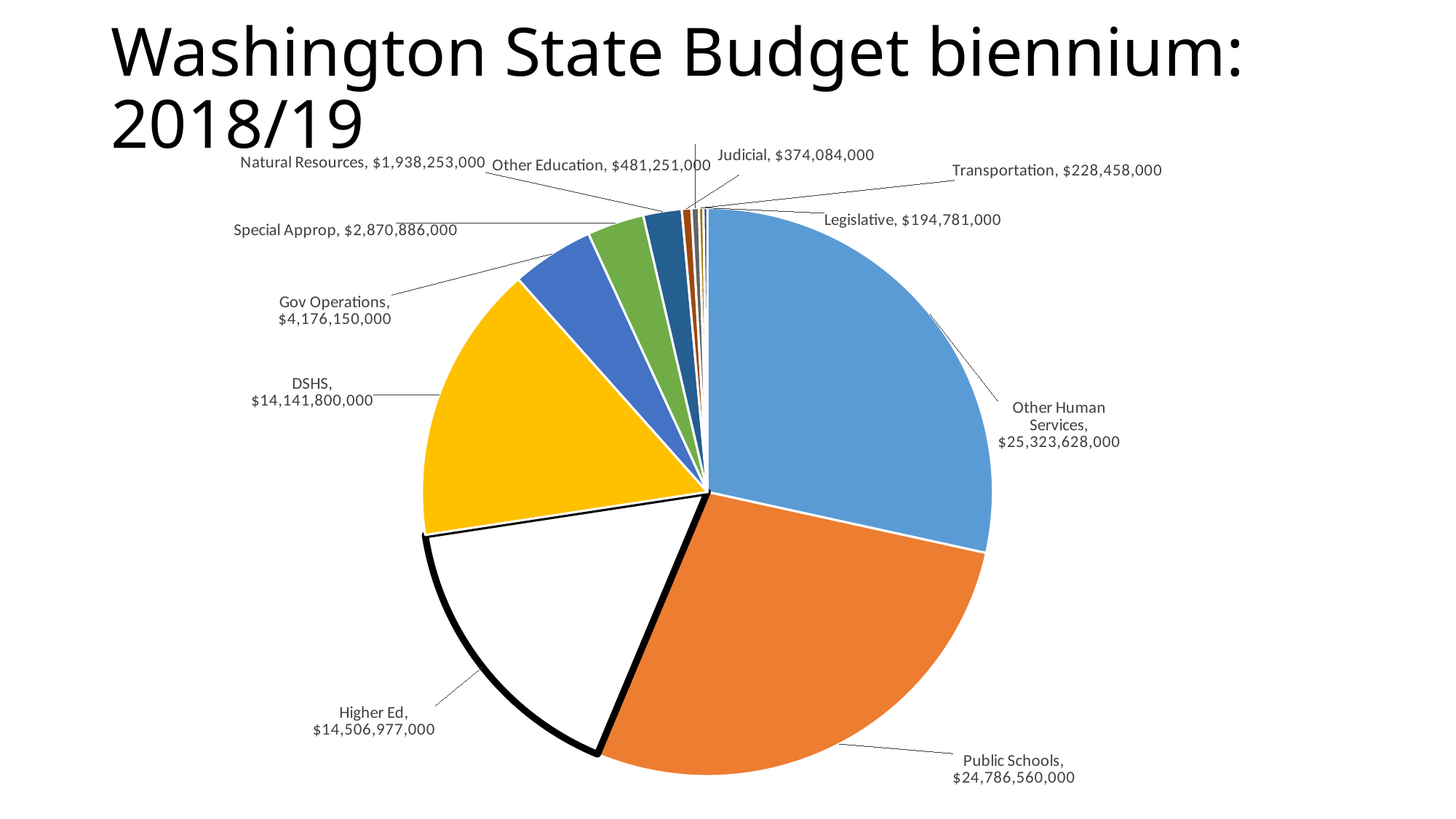
How many categories are shown in the pie chart? 11 What is the title of the slide? Washington State Budget biennium: 2018/19 Which category has the smallest value? Legislative Which category has the largest value? Other Human Services What is the value for Public Schools? $24,786,560,000 Which is larger, Judicial or Transportation? Judicial What is the value for Judicial? $374,084,000 What is the value for Gov Operations? $4,176,150,000 What is the difference between Other Human Services and Public Schools? $537,068,000 What kind of chart is shown on the slide? Pie chart What is the value for DSHS? $14,141,800,000 What is the difference between Higher Ed and DSHS? $365,177,000